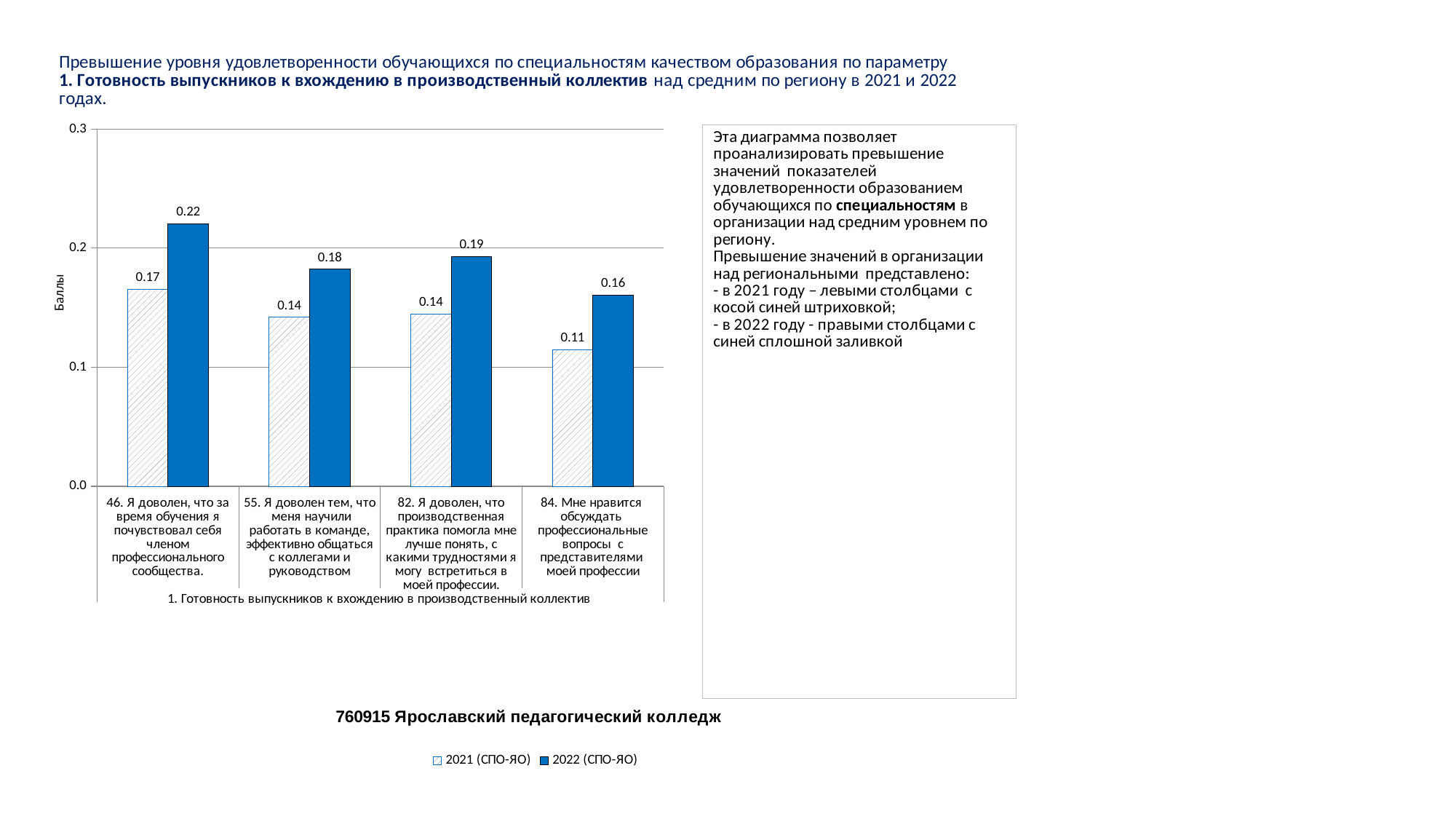
What is the 2022 (СПО-ЯО) value for category 46 (Я доволен, что за время обучения я почувствовал себя членом профессионального сообщества)? 0.22 Which is larger for category 55: the 2021 (СПО-ЯО) value or the 2022 (СПО-ЯО) value? 2022 (СПО-ЯО) What is the label of the vertical axis? Баллы Which category has the highest 2022 (СПО-ЯО) value? 46. Я доволен, что за время обучения я почувствовал себя членом профессионального сообщества. How many categories (questions) are shown on the x axis? 4 What type of chart is shown on the slide? bar chart Which category has the lowest 2021 (СПО-ЯО) value? 84. Мне нравится обсуждать профессиональные вопросы с представителями моей профессии Is the 2022 (СПО-ЯО) value for category 46 greater or less than 0.2? greater What is the difference between the 2022 and 2021 values for category 46? 0.05 What is the 2021 (СПО-ЯО) value for category 84 (Мне нравится обсуждать профессиональные вопросы с представителями моей профессии)? 0.11 What is the 2022 (СПО-ЯО) value for category 82 (Я доволен, что производственная практика помогла мне лучше понять...)? 0.19 How many series does the legend list? 2